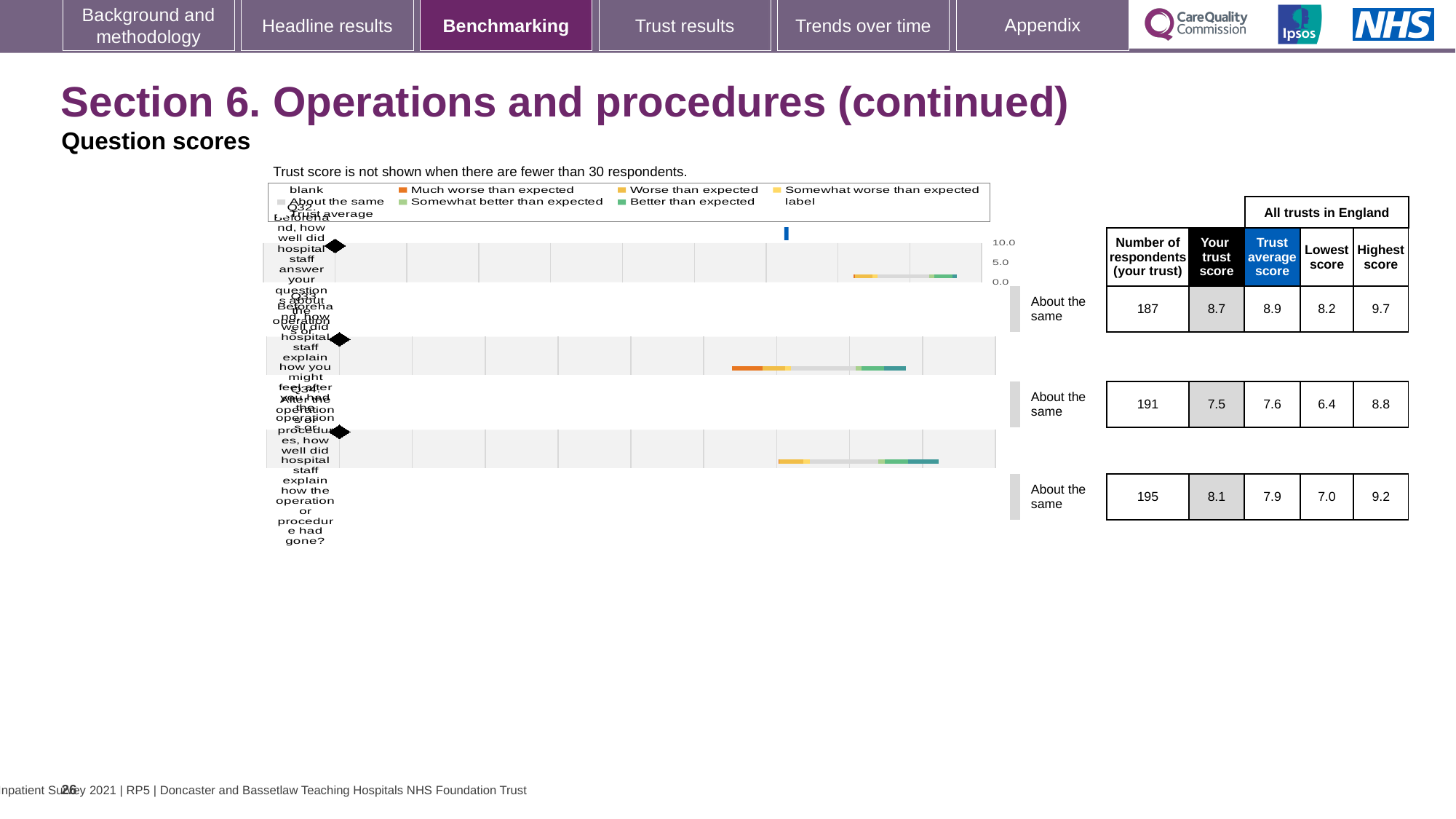
What kind of chart is used to show the question scores? Bar chart What benchmark category is shown for all three questions? About the same How many respondents answered Q34 (how well staff explained how the operation or procedure had gone)? 195 For Q34, which is larger: the trust score or the trust average score? The trust score (8.1) What is the difference between the highest score and the lowest score for Q32? 1.5 What is the trust average score for Q33 (how well staff explained how you might feel after the operation)? 7.6 What is the difference in the number of respondents between Q34 and Q32? 8 Is the trust score for Q33 greater or less than 5.0? greater Which question has the lowest trust score: Q32, Q33 or Q34? Q33 What is the trust score for Q32 (how well hospital staff answered questions about the operation or procedure beforehand)? 8.7 Which question has the highest trust score: Q32, Q33 or Q34? Q32 How many questions are plotted in the chart? 3